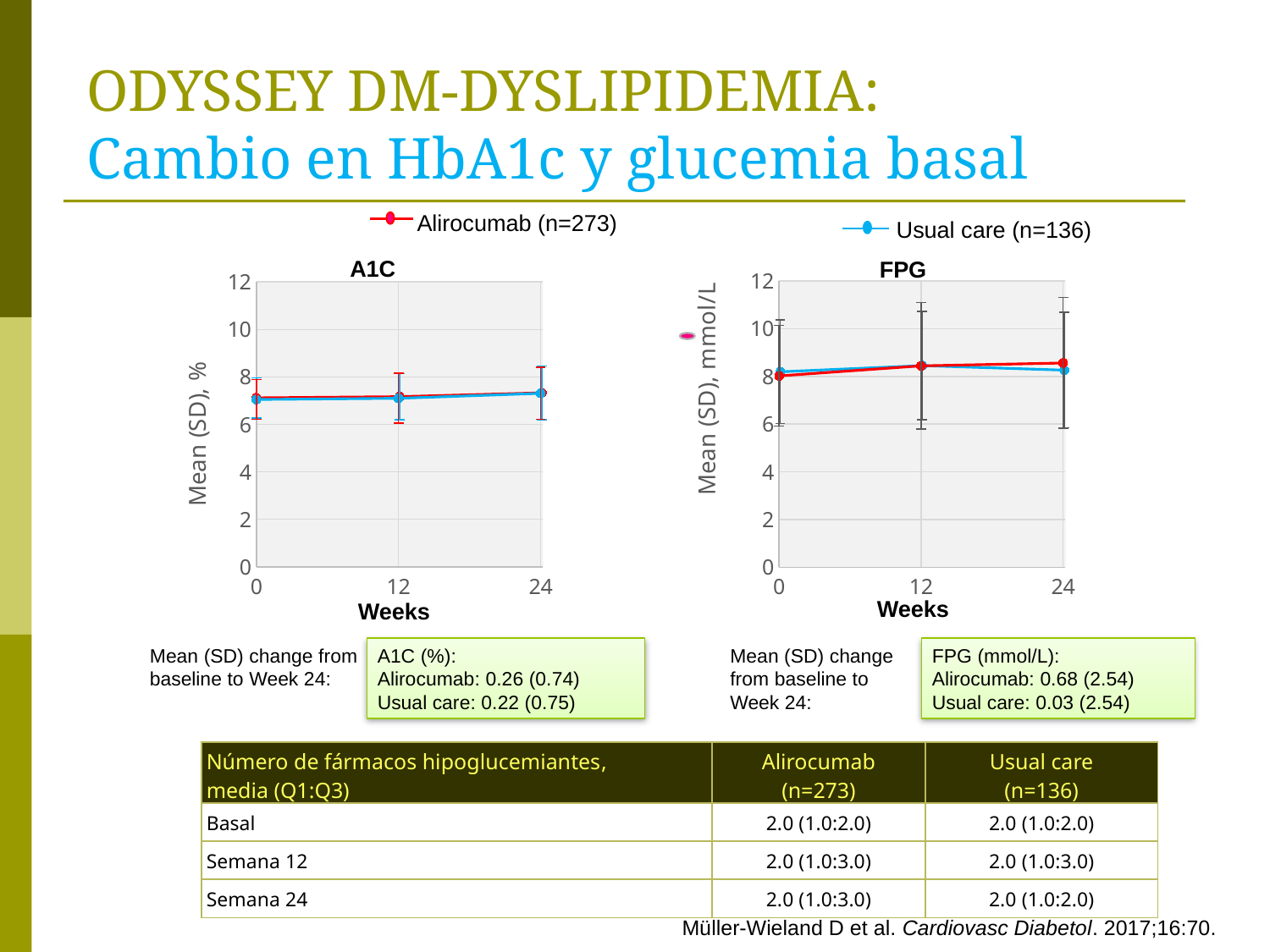
In the A1C chart, is the value for Usual care at week 24 greater or less than 8? less How many series does the legend list for the charts? 2 What kind of chart is the A1C chart? line chart What is the x-axis label of the A1C chart? Weeks In the FPG chart, is the value for Alirocumab at week 24 greater or less than 8? greater In the FPG chart, how many time points are plotted for each series? 3 What is the highest tick value shown on the y-axis of the A1C chart? 12 What is the y-axis label of the FPG chart? Mean (SD), mmol/L In the FPG chart, which series has the higher value at week 24, Alirocumab or Usual care? Alirocumab In the FPG chart, does the Alirocumab line rise or fall from week 0 to week 24? rise In the A1C chart, is the value for Alirocumab at week 0 greater or less than 6? greater